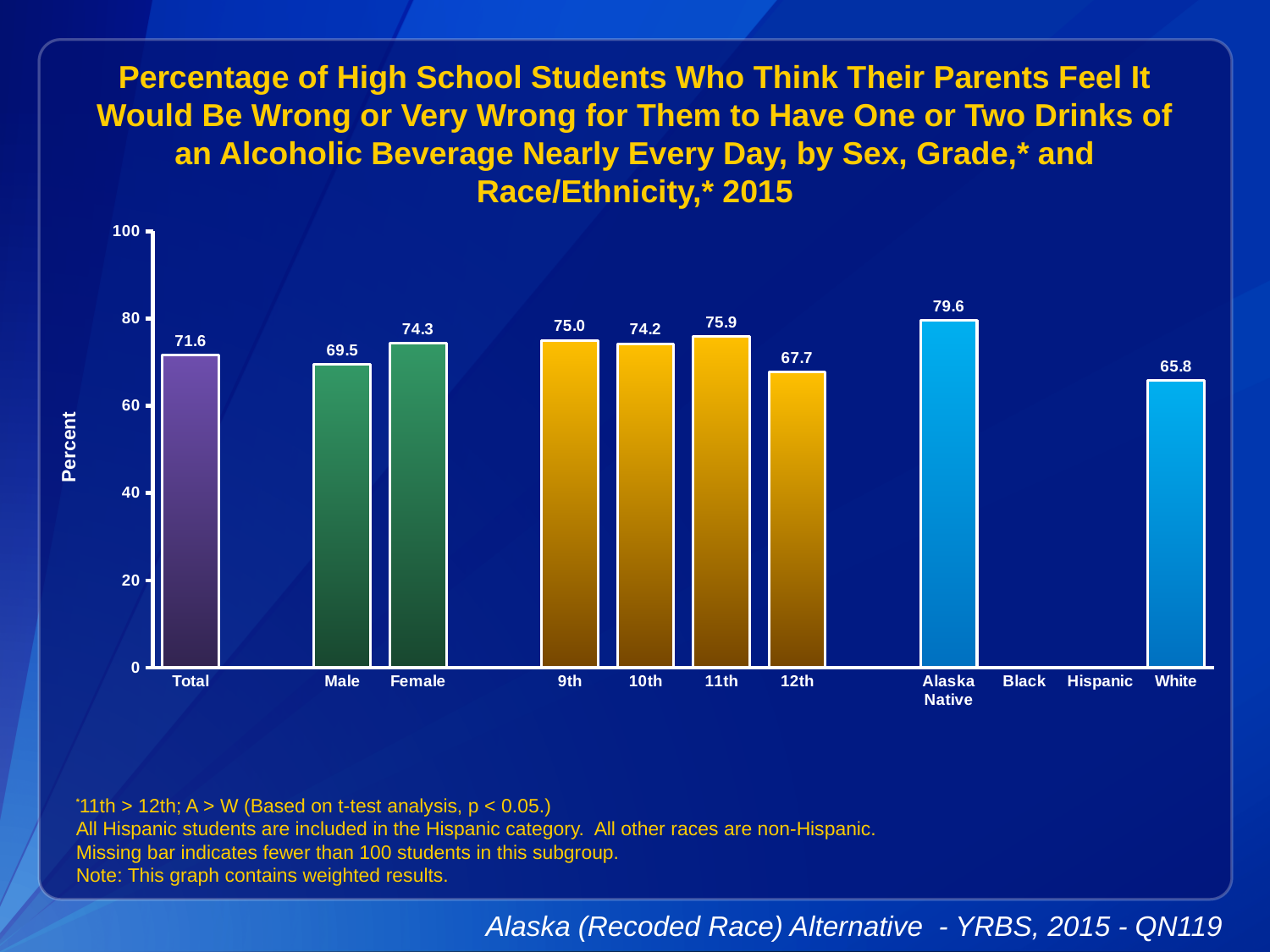
What is the value for Female? 74.3 How many categories have a bar plotted on the chart? 9 What is the difference between the Female and Male values? 4.8 What kind of chart is shown? bar chart What is the value for 12th grade? 67.7 Which category has the highest value? Alaska Native What is the label on the vertical axis? Percent Which category has the lowest value among those with a bar shown? White Is the value for 9th grade greater or less than 60? greater What is the difference between the Alaska Native and White values? 13.8 What is the value for Total? 71.6 Which is larger, the value for 11th grade or the value for 12th grade? 11th